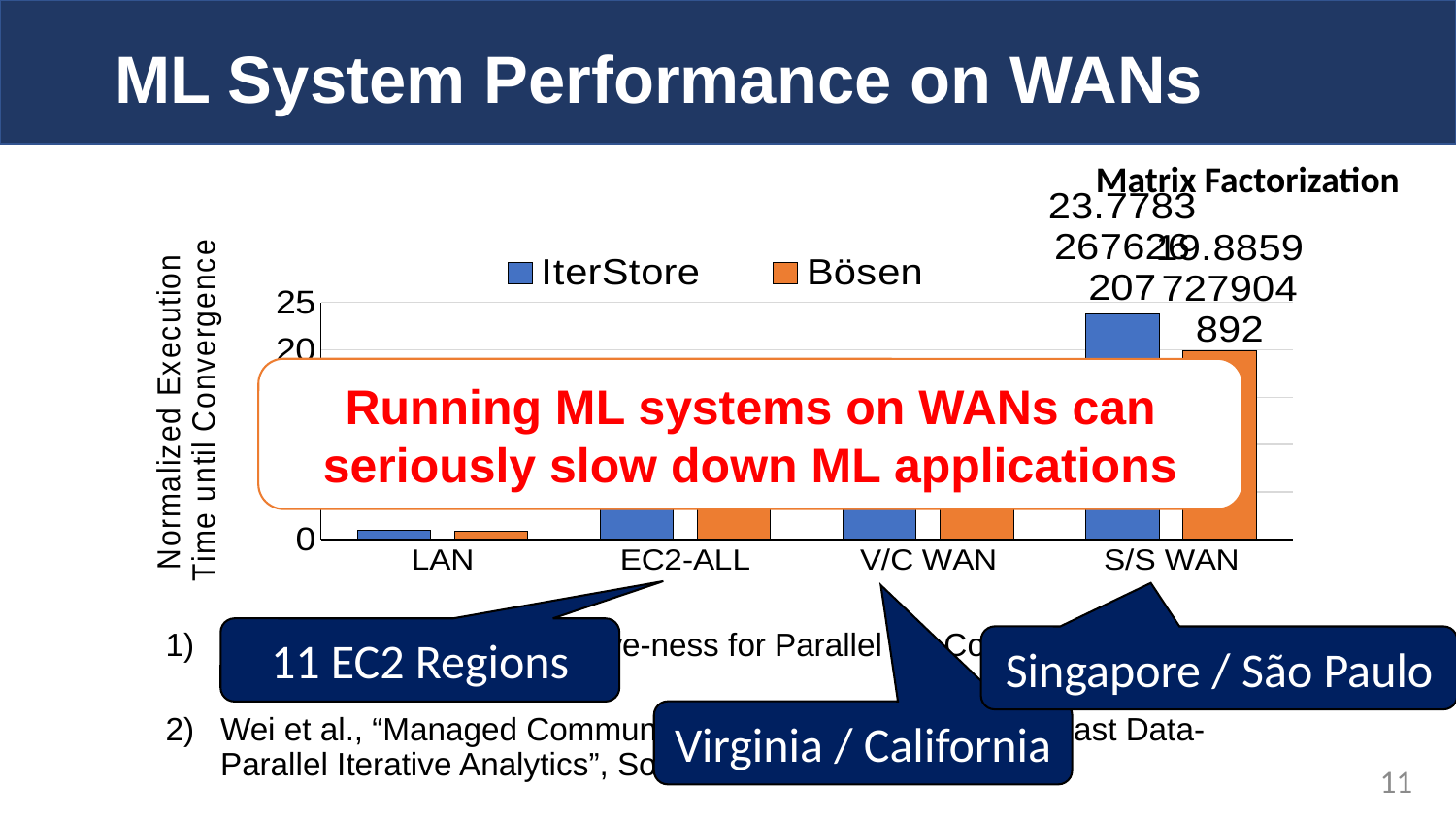
How many categories are shown on the x axis of the chart? 4 Which two series are listed in the chart legend? IterStore and Bösen What is the title shown above the chart? Matrix Factorization Do the bar values generally rise or fall from LAN to S/S WAN along the x axis? rise For S/S WAN, which series has the larger value, IterStore or Bösen? IterStore Is the IterStore value for LAN greater or less than 20? less What kind of chart is shown on the slide? bar chart Which is larger, the Bösen value for S/S WAN or the Bösen value for LAN? S/S WAN How many series does the chart legend list? 2 Is the IterStore value for S/S WAN greater or less than 20? greater Which category has the highest bars in the chart? S/S WAN Which category has the lowest bars in the chart? LAN